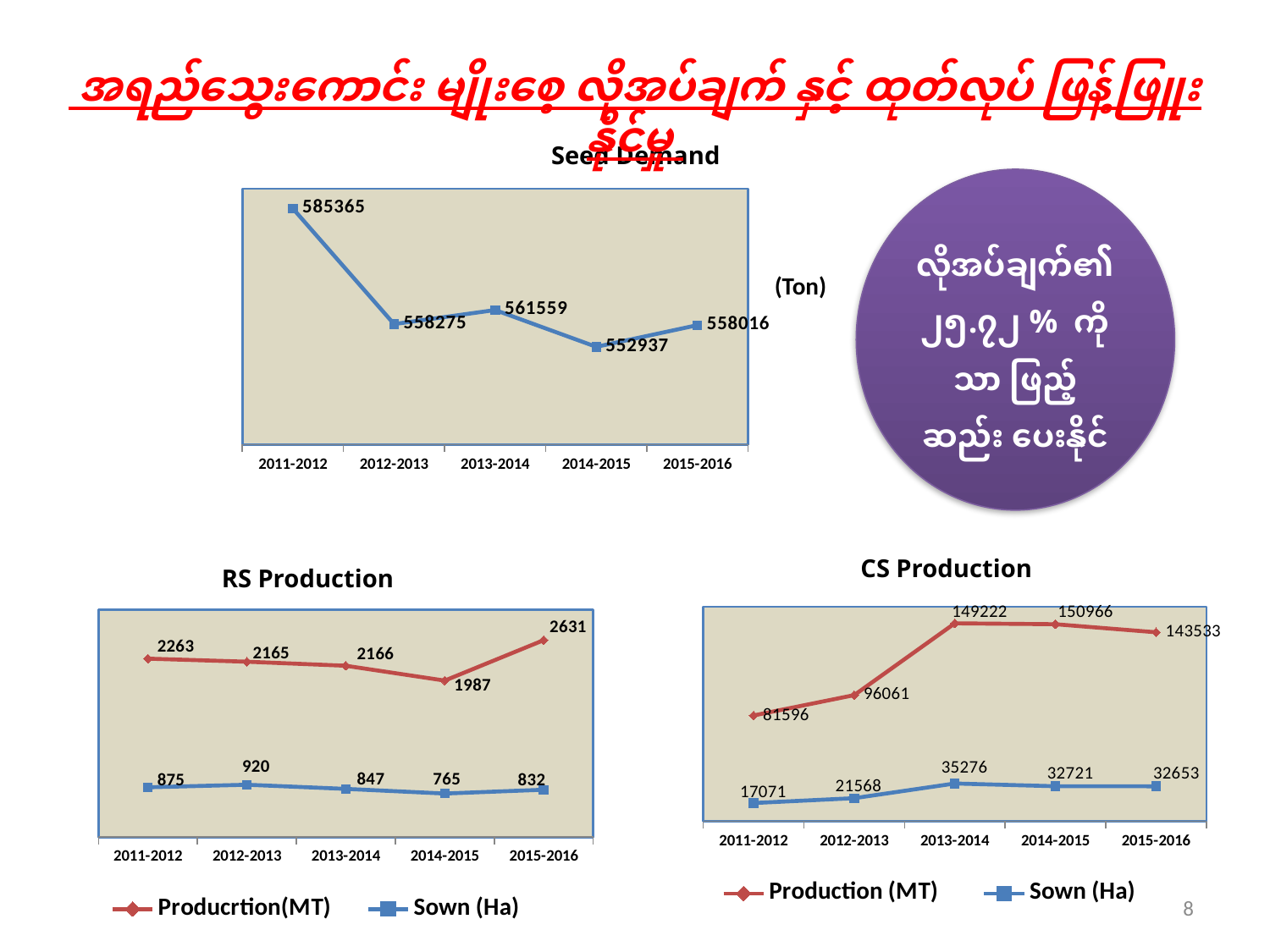
In the Seed Demand chart, what is the value for 2011-2012? 585365 In the CS Production chart, is the Production (MT) value for 2011-2012 larger or smaller than the value for 2012-2013? smaller In the RS Production chart, what is the Producrtion(MT) value for 2015-2016? 2631 In the CS Production chart, what is the Sown (Ha) value for 2013-2014? 35276 In the Seed Demand chart, which year has the lowest seed demand? 2014-2015 In the RS Production chart, what is the difference between Producrtion(MT) and Sown (Ha) in 2011-2012? 1388 In the Seed Demand chart, what is the difference between the 2011-2012 value and the 2012-2013 value? 27090 In the CS Production chart, which year has the highest Production (MT) value? 2014-2015 In the RS Production chart, how many series does the legend list? 2 In the RS Production chart, which year has the highest Sown (Ha) value? 2012-2013 What kind of chart is the CS Production chart? line chart In the Seed Demand chart, how many data points are plotted? 5